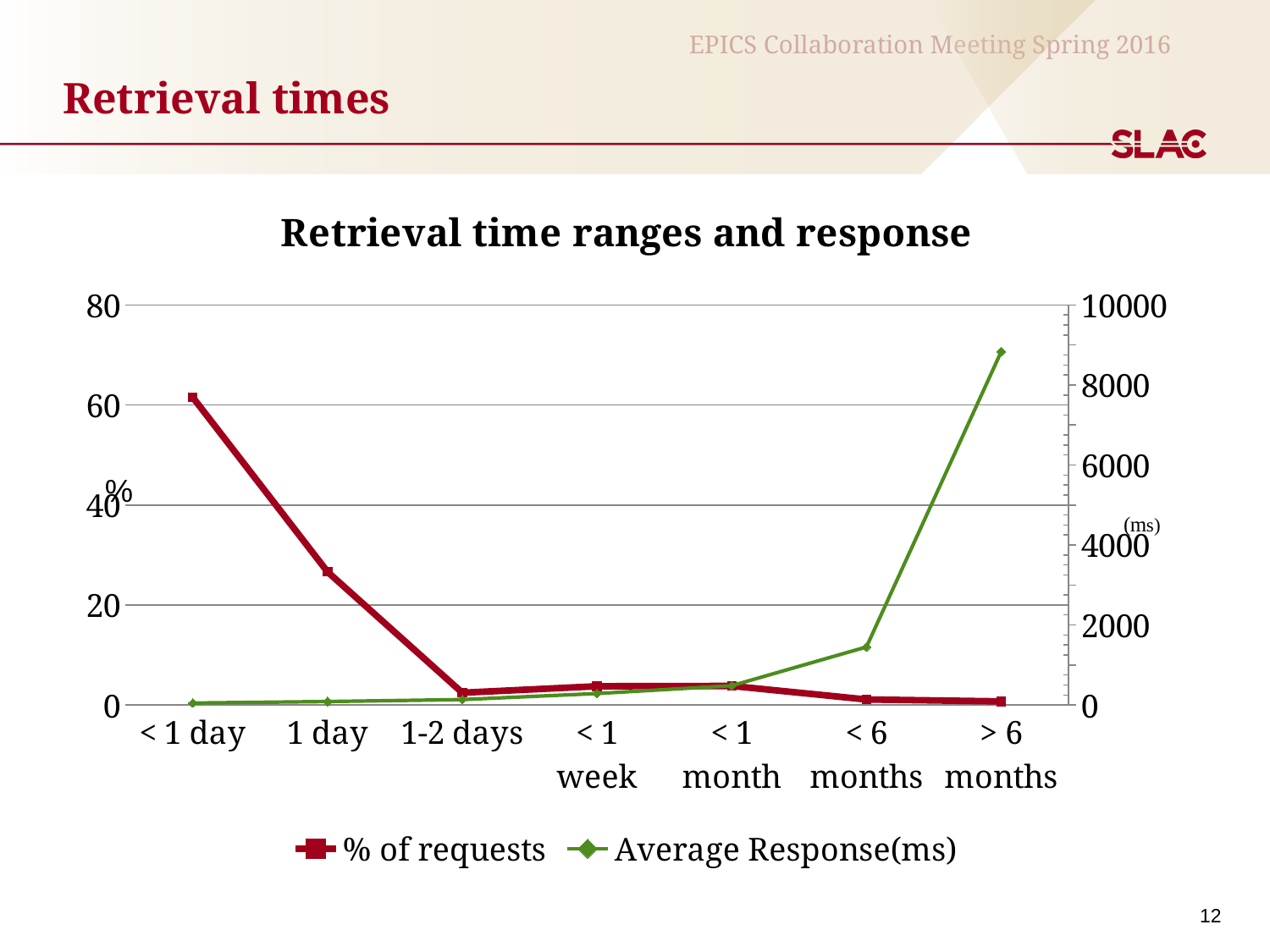
How many categories are shown on the x axis of the chart? 7 Which category has the highest value for Average Response(ms)? > 6 months Does the Average Response(ms) series generally rise or fall from < 1 day to > 6 months? rise Is the % of requests value for 1 day greater or less than 40? less What is the title of the chart? Retrieval time ranges and response Is the Average Response(ms) value for < 6 months greater or less than 2000? less Is the Average Response(ms) value for > 6 months greater or less than 8000? greater Which category has the highest value for % of requests? < 1 day How many series does the chart's legend list? 2 What kind of chart is shown on the slide? line chart Which is larger, the % of requests for < 1 day or for 1 day? < 1 day